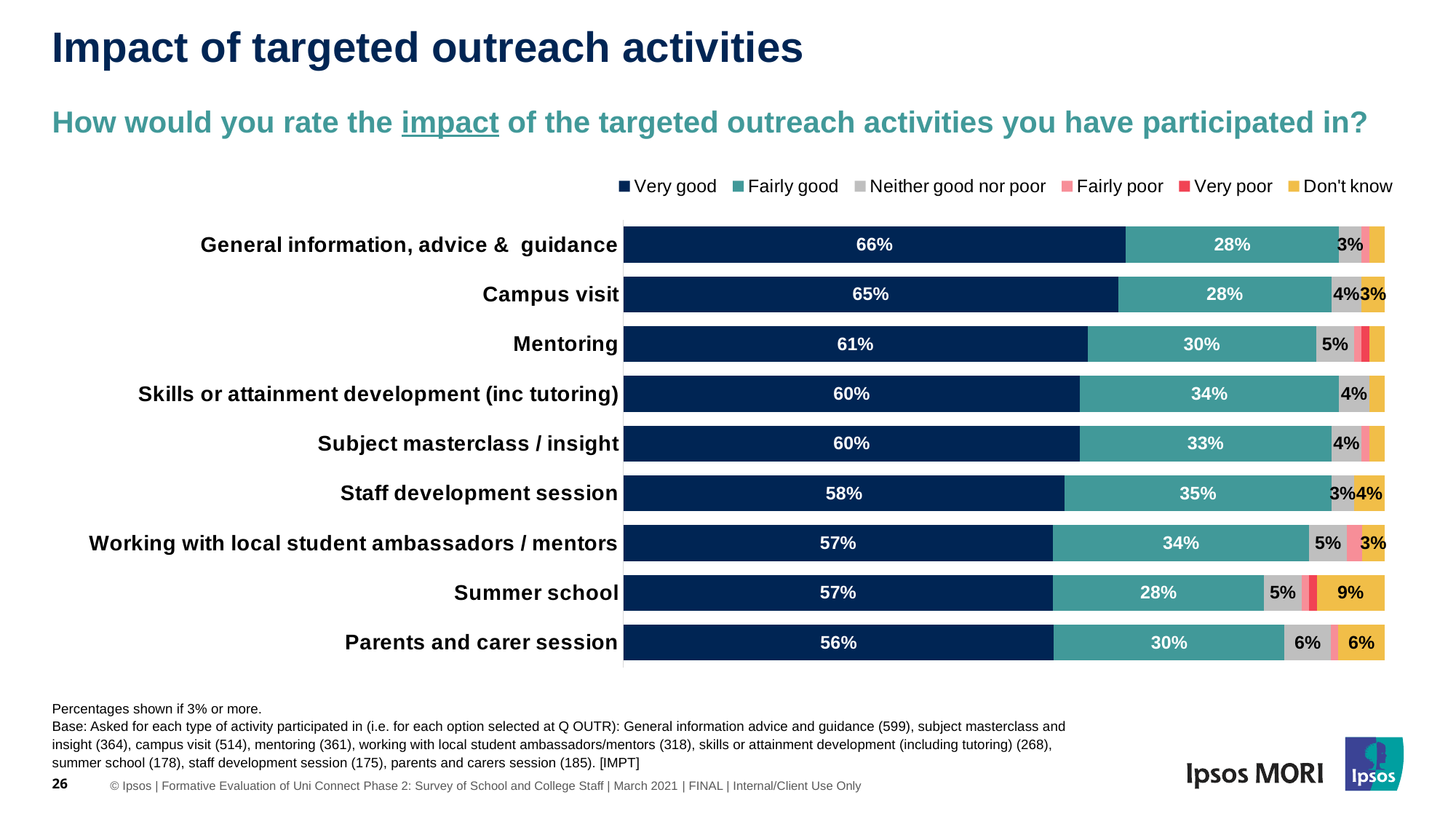
How many series does the legend list? 6 Which activity has the lowest Very good percentage? Parents and carer session What is the Neither good nor poor percentage for Parents and carer session? 6% What is the Don't know percentage for Summer school? 9% What is the difference between the Very good percentages for General information, advice & guidance and Parents and carer session? 10% Which has a larger Fairly good percentage: Mentoring or Skills or attainment development (inc tutoring)? Skills or attainment development (inc tutoring) What is the Fairly good percentage for Staff development session? 35% Which activity has the highest Very good percentage? General information, advice & guidance What type of chart is shown on the slide? Stacked bar chart Which legend entry is shown in yellow? Don't know What percentage of respondents rated the impact of General information, advice & guidance as Very good? 66% How many activities are shown in the chart? 9